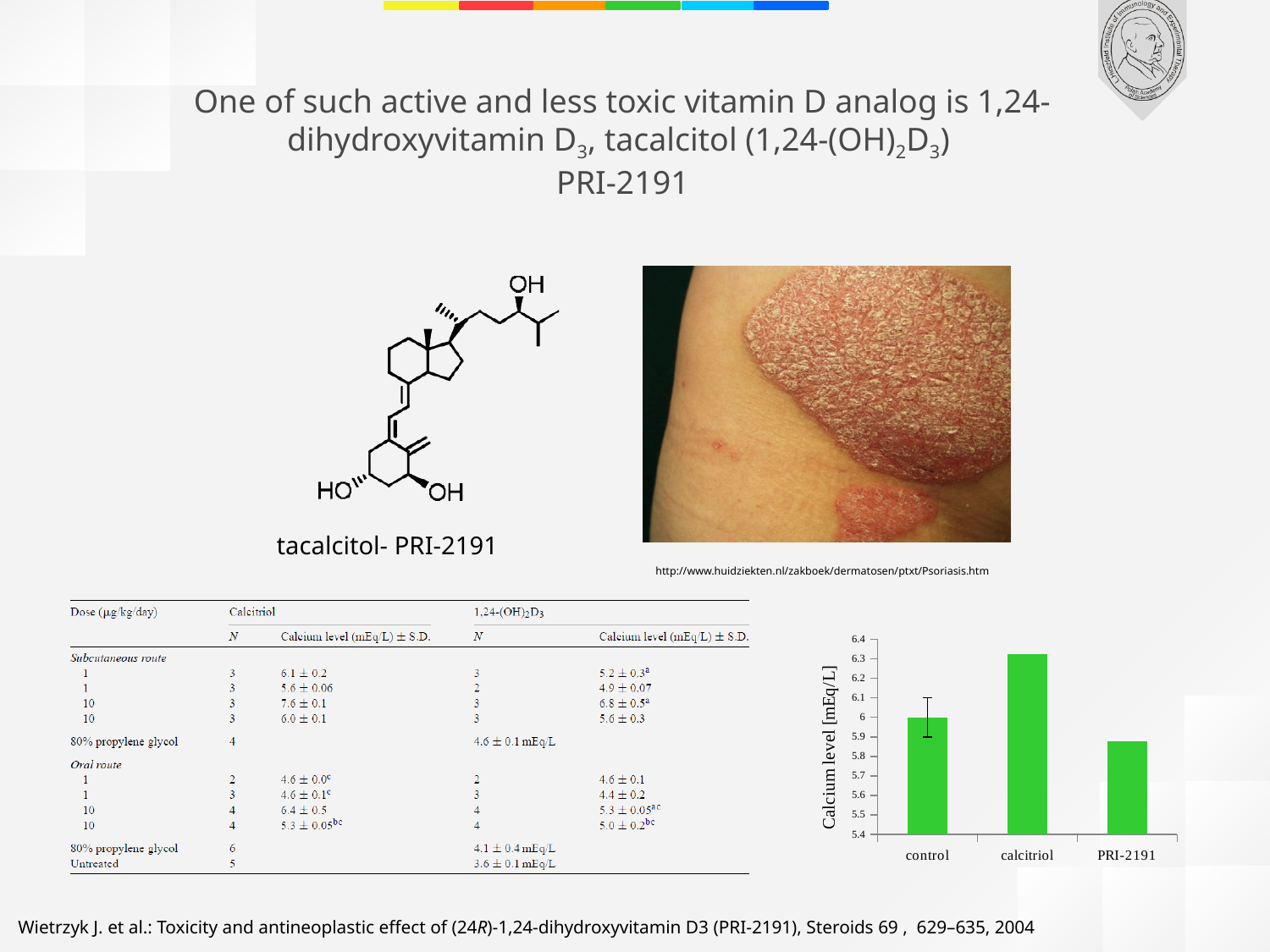
Which category in the bar chart has the lowest calcium level? PRI-2191 How many categories are shown on the x axis of the bar chart? 3 What is the y-axis title of the bar chart? Calcium level [mEq/L] In the bar chart, which has a higher calcium level, control or PRI-2191? control Is the value for calcitriol in the bar chart greater or less than 6.2? greater In the bar chart, which has a higher calcium level, calcitriol or control? calcitriol What colour are the bars in the bar chart? green What kind of chart is shown at the bottom right of the slide? bar chart Which category in the bar chart has the highest calcium level? calcitriol Is the value for PRI-2191 in the bar chart greater or less than 6? less Is the value for PRI-2191 in the bar chart greater or less than 5.8? greater